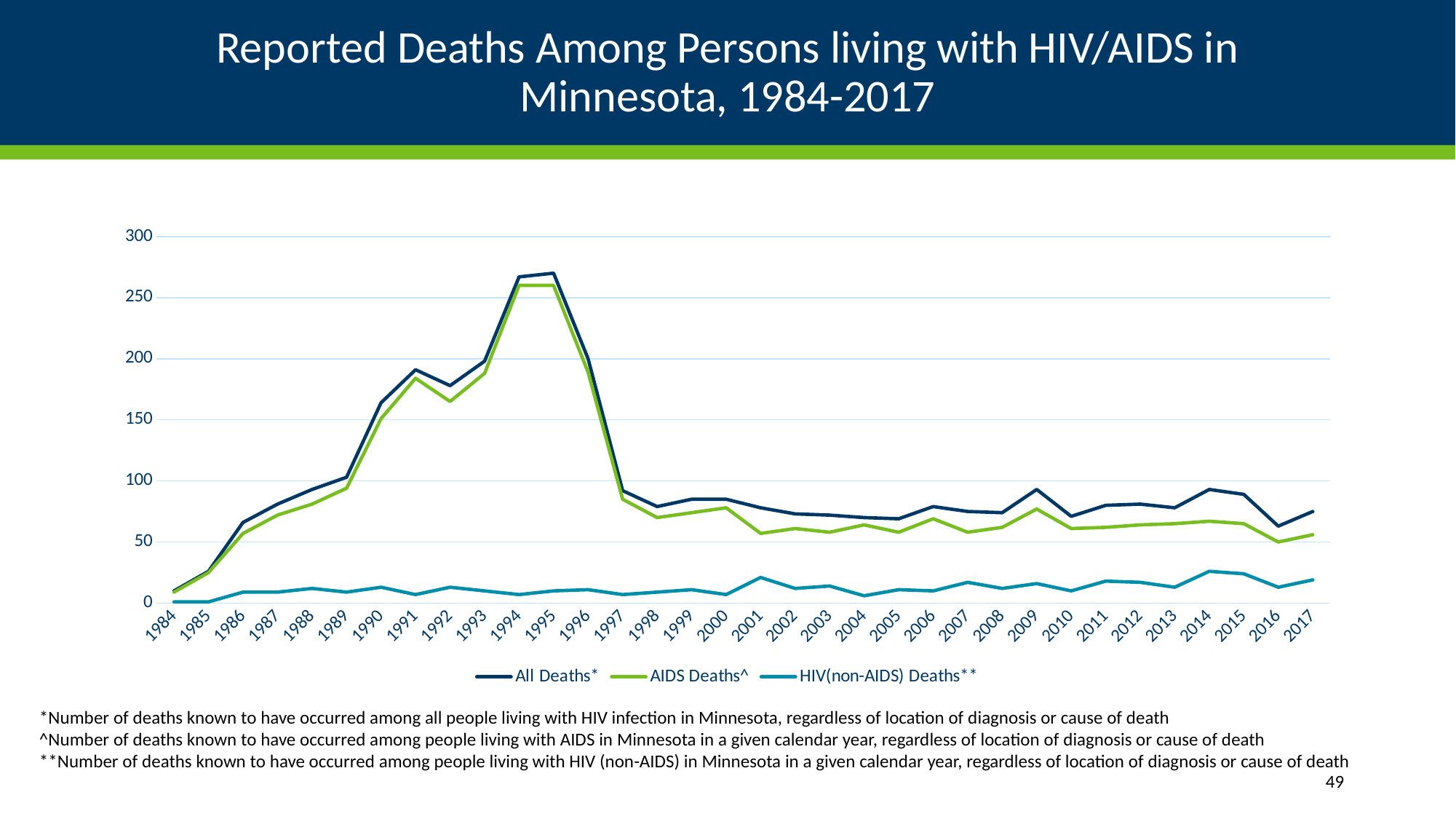
Which is larger in 2010, All Deaths* or HIV(non-AIDS) Deaths**? All Deaths* Which series has the highest values across the chart? All Deaths* Is the value for HIV(non-AIDS) Deaths** in 2014 greater or less than 50? less Which year has the lowest value for All Deaths*? 1984 Is the value for All Deaths* in 1991 greater or less than 150? greater Do the values for All Deaths* rise or fall from 1995 to 1997? Fall Is the value for All Deaths* in 1995 greater or less than 250? greater How many series does the legend list? 3 What is the title of the chart? Reported Deaths Among Persons living with HIV/AIDS in Minnesota, 1984-2017 How many years are plotted along the x axis? 34 What kind of chart is shown on the slide? Line chart